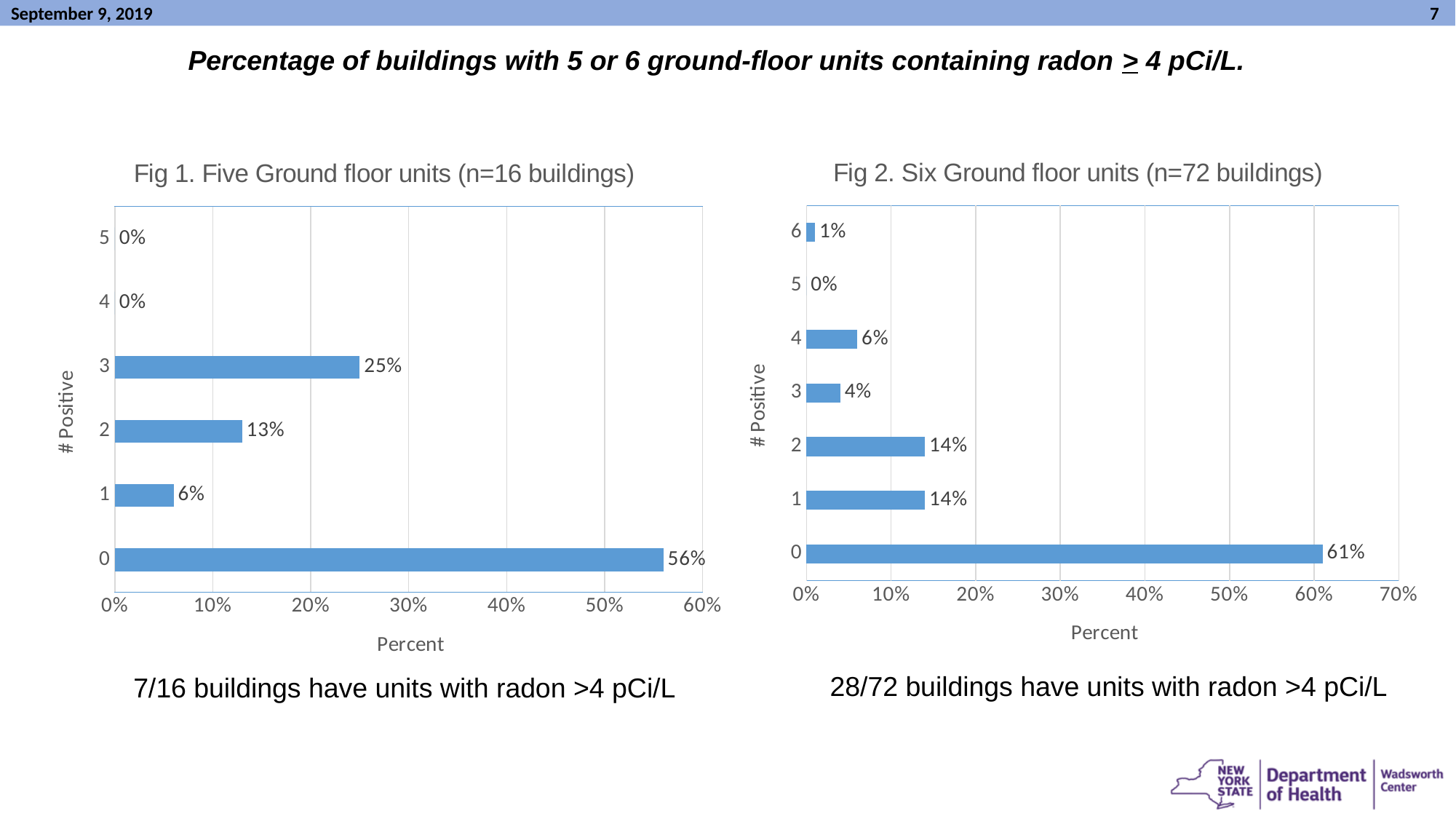
In Fig 1 (Five Ground floor units), is the value for 0 positive units greater or less than 50%? greater In Fig 2 (Six Ground floor units), what percentage of buildings have 0 positive units? 61% In Fig 1 (Five Ground floor units), what is the difference between the percentages for 0 positive units and 3 positive units? 31% In Fig 2 (Six Ground floor units), what percentage of buildings have 4 positive units? 6% In Fig 2 (Six Ground floor units), which # Positive category has the lowest non-zero percentage? 6 In Fig 1 (Five Ground floor units), what percentage of buildings have 3 positive units? 25% What kind of chart is Fig 1 (Five Ground floor units)? Bar chart In Fig 1 (Five Ground floor units), which # Positive category has the highest percentage? 0 What is the x-axis label of Fig 1 (Five Ground floor units)? Percent In Fig 2 (Six Ground floor units), what is the total of the percentages for 1 and 2 positive units? 28% In Fig 2 (Six Ground floor units), which is larger: the percentage for 4 positive units or for 3 positive units? 4 positive units How many # Positive categories are shown in Fig 2 (Six Ground floor units)? 7